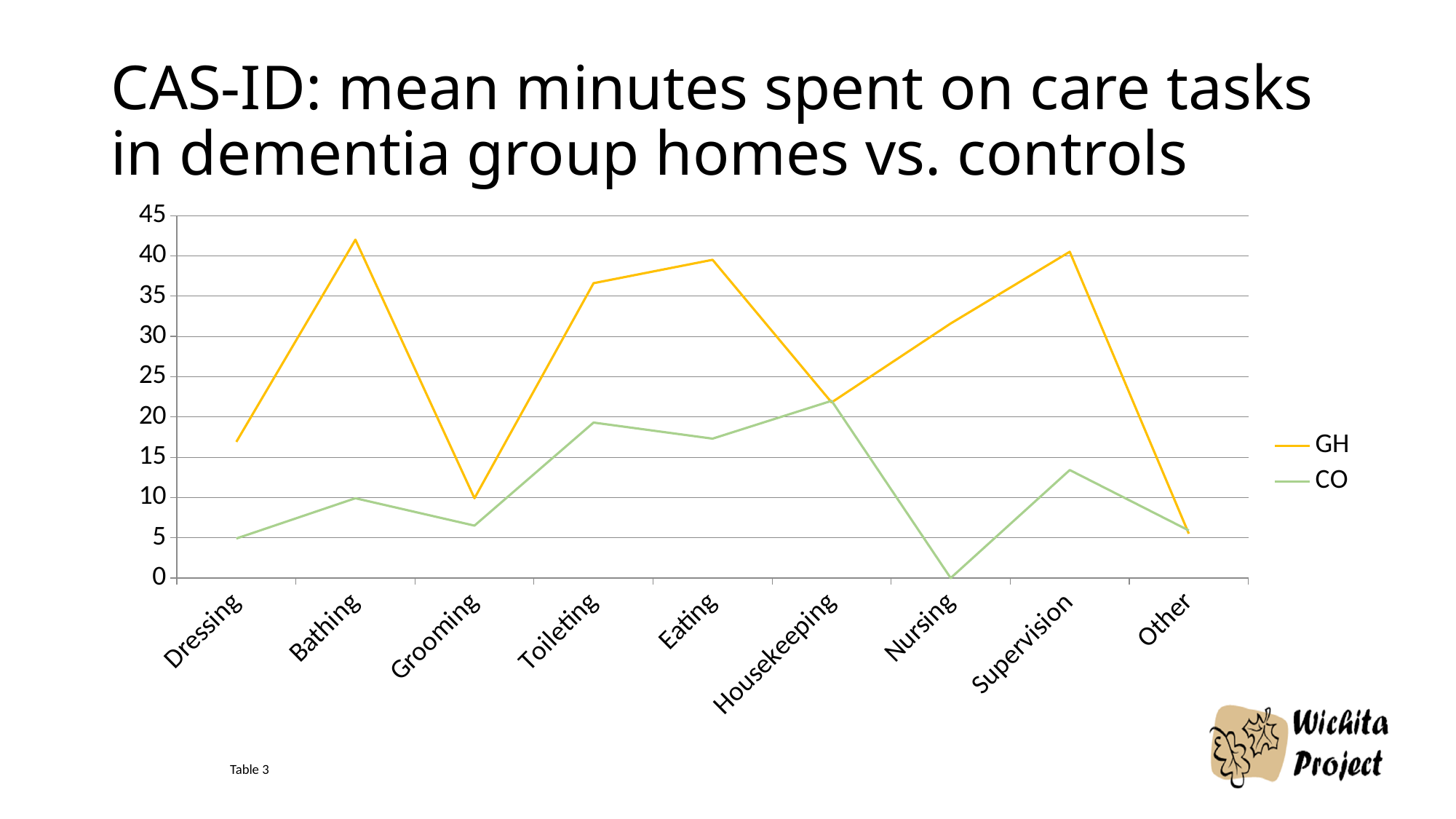
Is the CO value for Dressing greater or less than 10? less Which category has the lowest value for the CO series? Nursing For Nursing, which series has the larger value, GH or CO? GH Is the GH value for Bathing greater or less than 40? greater Is the GH value for Grooming greater or less than 15? less Does the GH line rise or fall from Housekeeping to Supervision? rise How many series does the legend list? 2 What kind of chart is shown on the slide? line chart Which category has the highest value for the CO series? Housekeeping How many care task categories are shown on the x axis? 9 What are the two series named in the legend? GH and CO Which category has the lowest value for the GH series? Other